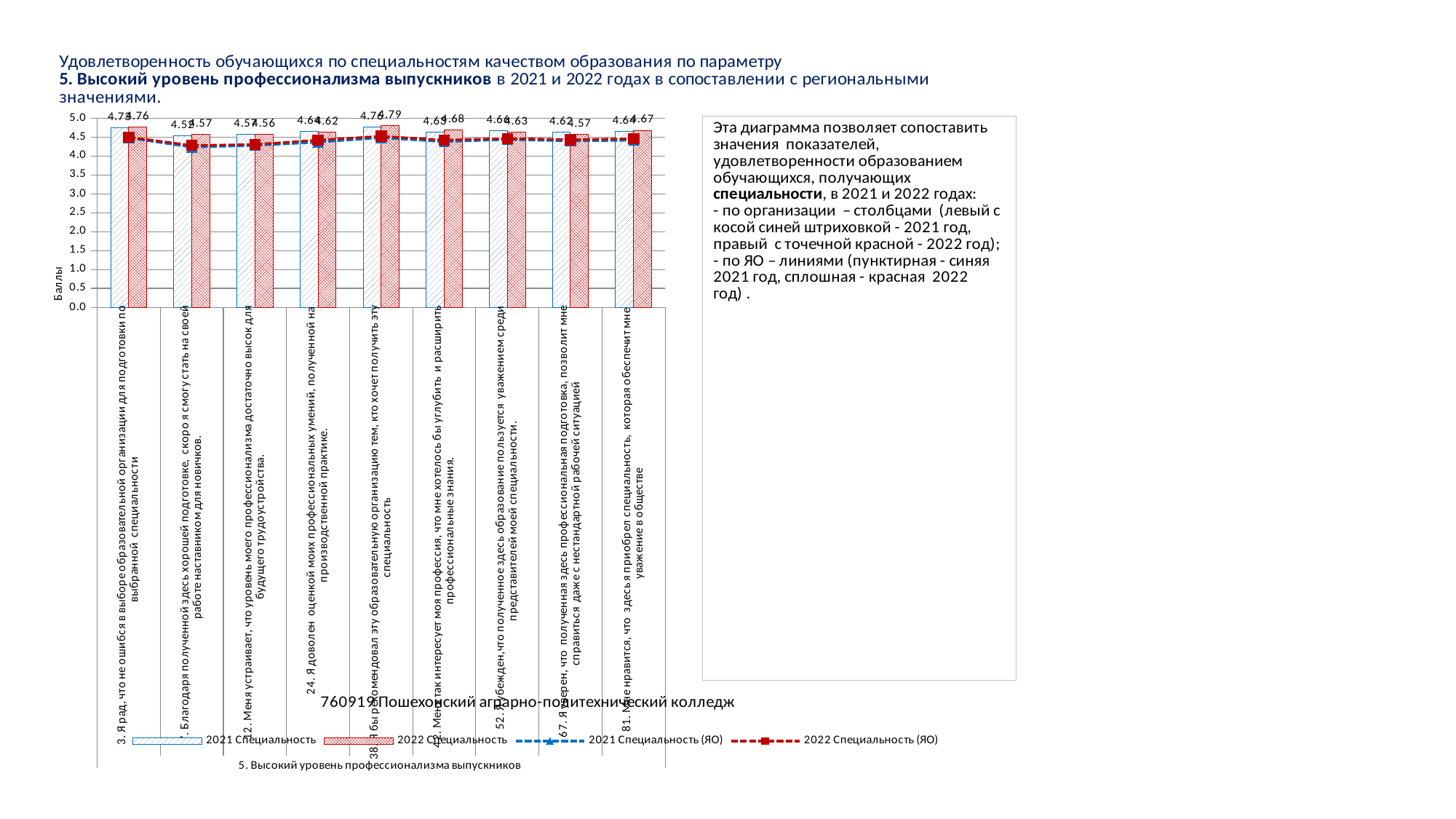
For statement 67, which is larger: the 2021 Специальность value or the 2022 Специальность value? 2021 Специальность (4.62) Which category has the lowest 2021 Специальность value? The second category, 4.52 Which category has the highest 2022 Специальность value? The fifth category (statement 38), 4.79 What is the difference between the 2022 and 2021 Специальность values for statement 3 (Я рад, что не ошибся в выборе образовательной организации)? 0.03 What is the title of the vertical axis? Баллы What is the 2022 Специальность value for statement 67 (Я уверен, что полученная здесь профессиональная подготовка позволит мне справиться даже с нестандартной рабочей ситуацией)? 4.57 How many series does the chart legend list? 4 Is the 2021 Специальность (ЯО) line value for statement 3 greater or less than 4.0? greater What type of chart is used to show the organisation's values for 2021 and 2022? Bar chart How many categories (survey statements) are shown on the x axis of the chart? 9 What is the 2022 Специальность value for statement 81 (Мне нравится, что здесь я приобрел специальность, которая обеспечит мне уважение в обществе)? 4.67 What is the 2021 Специальность value for statement 24 (Я доволен оценкой моих профессиональных умений, полученной на производственной практике)? 4.64